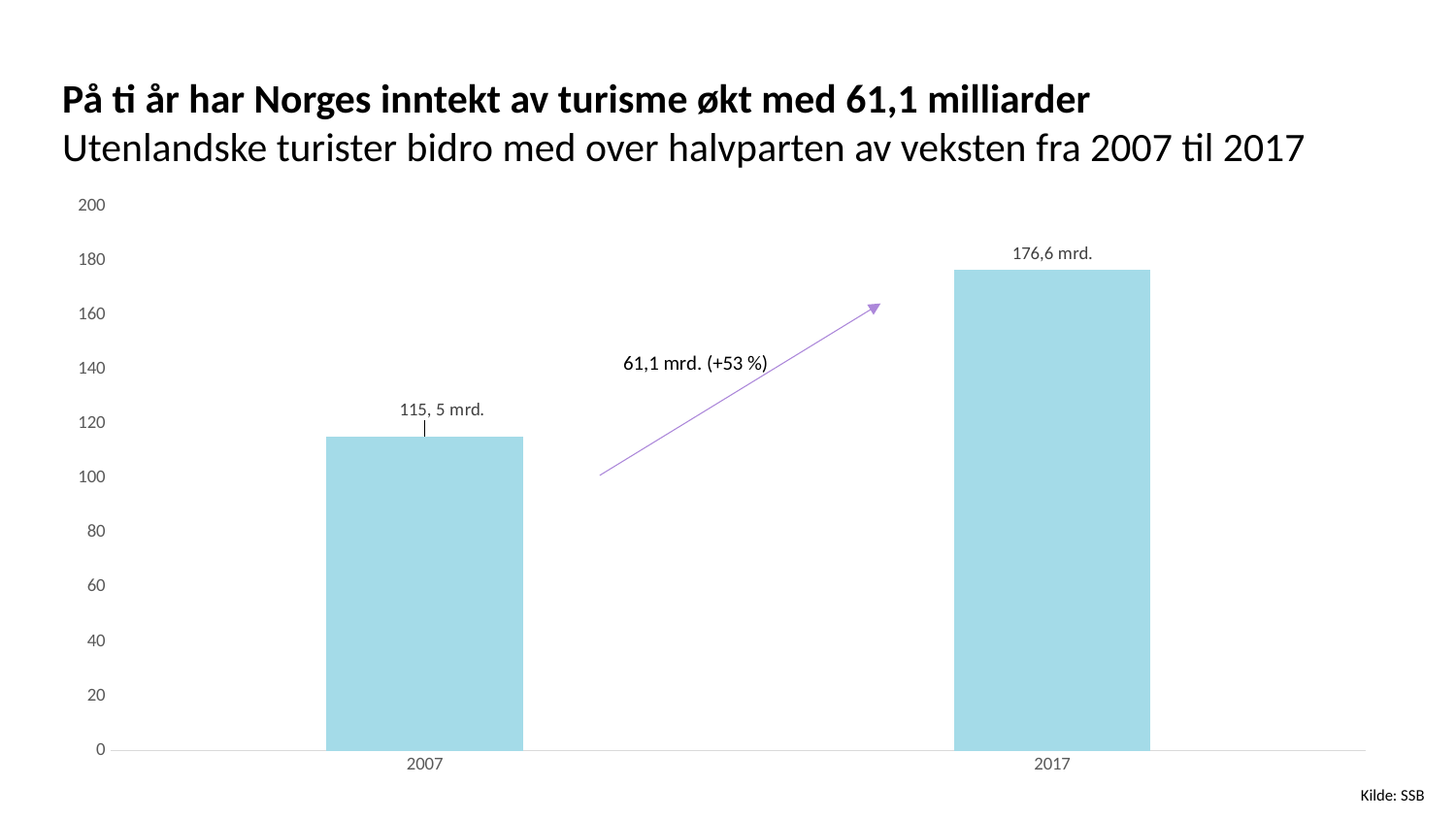
Is the value for 2007 greater or less than 120? less What is the value shown for 2017? 176,6 mrd. What increase is labelled on the arrow between the two bars? 61,1 mrd. (+53 %) What kind of chart is shown on the slide? bar chart Which year has the highest value? 2017 What is the value shown for 2007? 115, 5 mrd. How many bars are plotted in the chart? 2 Is the value for 2017 greater or less than 160? greater What source is cited for the chart? SSB Do the values rise or fall from 2007 to 2017? rise Which year has the lowest value? 2007 Which year has the higher value, 2007 or 2017? 2017